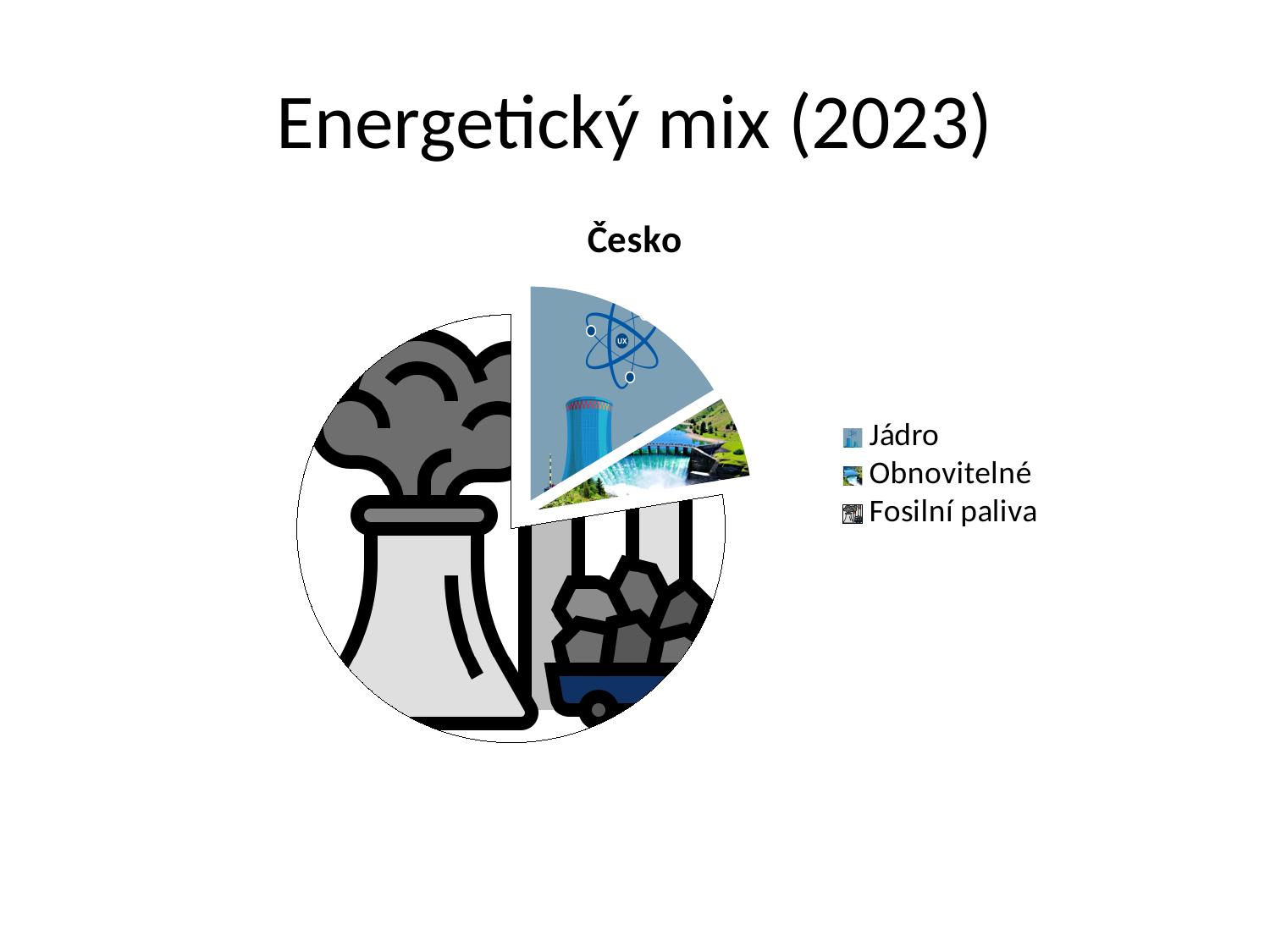
Which slice is larger, Fosilní paliva or Jádro? Fosilní paliva Which legend entry is listed first? Jádro Which slice is larger, Jádro or Obnovitelné? Jádro How many slices does the pie chart have? 3 How many entries does the legend list? 3 Which category has the largest slice of the pie? Fosilní paliva What kind of chart is shown on the slide? pie chart Which category has the smallest slice of the pie? Obnovitelné What is the title of the chart? Česko